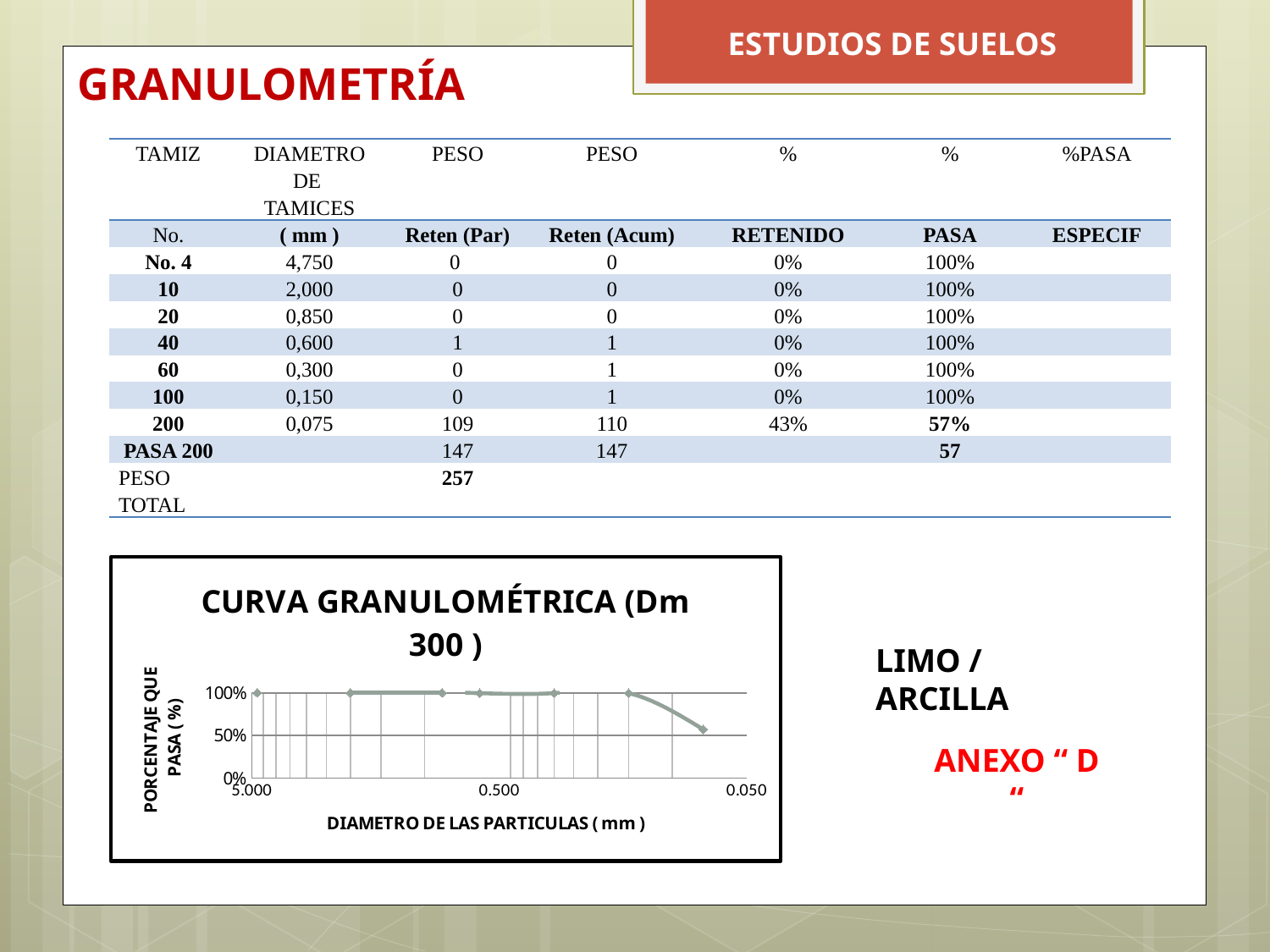
How many tick labels are shown on the y axis of the chart? 3 Do the plotted values rise or fall moving from left to right along the x axis? fall What kind of chart is shown on the slide? line chart What is the percentage passing for the leftmost point on the chart, at a diameter of 5.000 mm? 100% How many data points are plotted on the line in the chart? 7 What is the title of the x axis of the chart? DIAMETRO DE LAS PARTICULAS ( mm ) What is the title of the chart? CURVA GRANULOMÉTRICA (Dm 300 ) Which point has the larger percentage passing, the leftmost point or the rightmost point? the leftmost point Which point on the chart has the lowest percentage passing? the rightmost point (smallest diameter) Is the percentage passing for the rightmost point on the chart greater or less than 100%? less